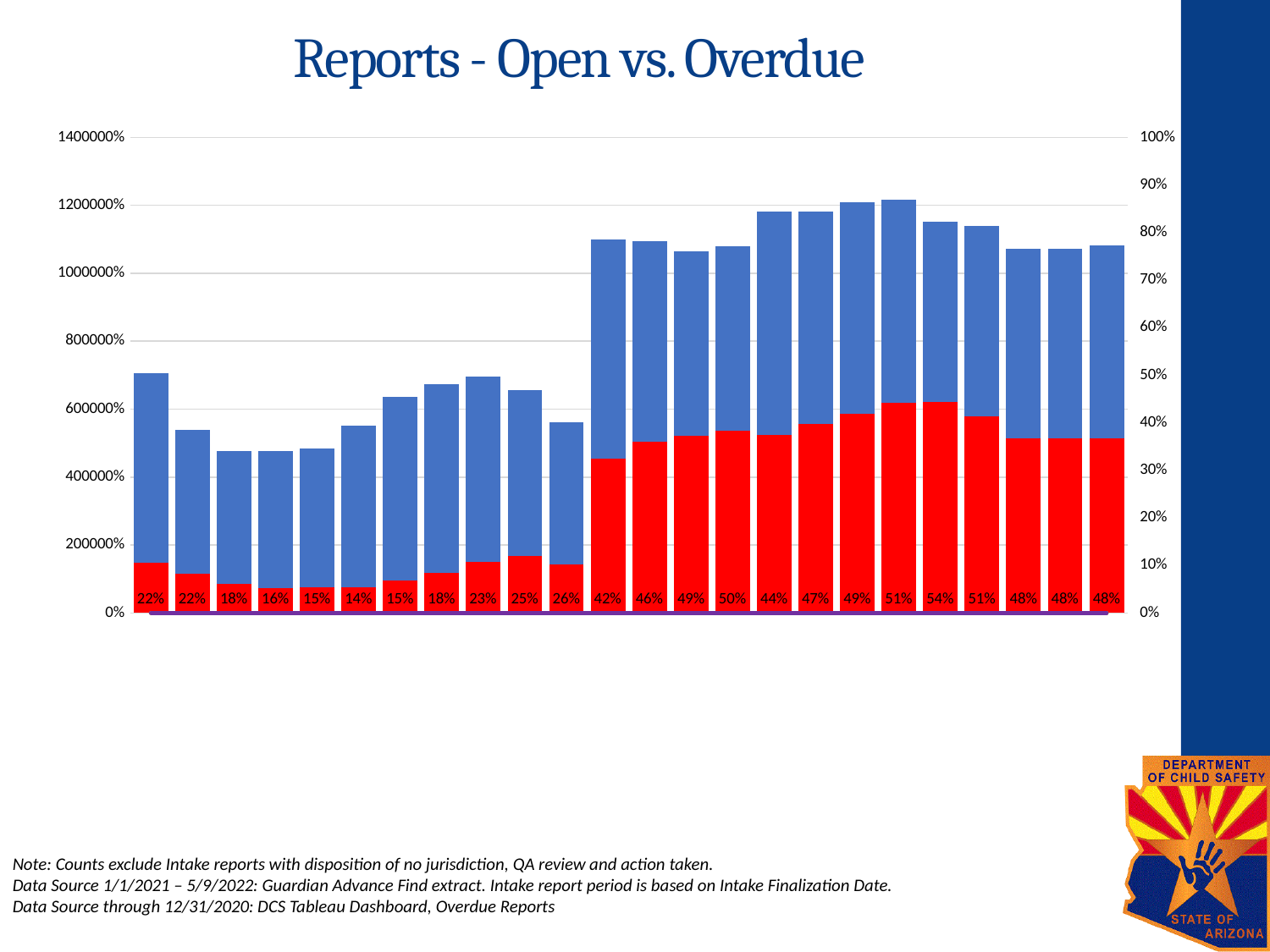
Are the percentage labels on the bars in the right half of the chart generally higher or lower than those on the bars in the left half? higher What is the lowest percentage label shown on the red bars? 14% What is the title of the chart? Reports - Open vs. Overdue What is the difference between the percentage label on the rightmost bar and the percentage label on the leftmost bar? 26 percentage points What percentage label is shown on the last (rightmost) bar? 48% How many bars carry a percentage label of 48%? 3 What is the highest percentage label shown on the red bars? 54% What percentage label is shown on the first (leftmost) bar? 22% Is the total height of the leftmost bar on the left axis greater or less than 800000%? less Which has the larger percentage label, the leftmost bar or the rightmost bar? the rightmost bar What kind of chart is shown on the slide? bar chart How many bars are plotted in the chart? 24